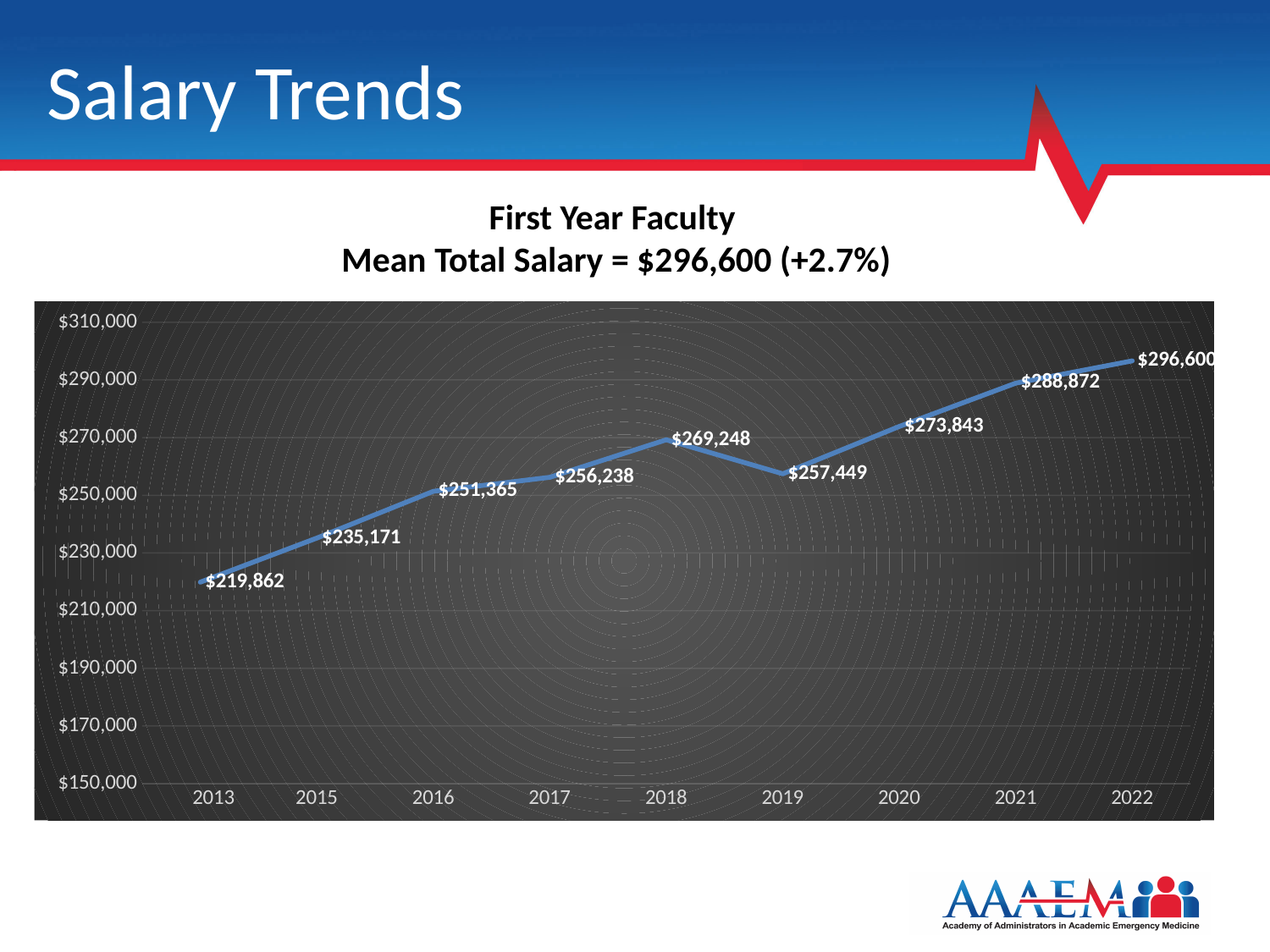
What is the difference between the mean total salary in 2018 and in 2019? $11,799 Which year has the lowest mean total salary? 2013 What is the difference between the mean total salary in 2022 and in 2021? $7,728 What kind of chart is shown on the slide? line chart What is the mean total salary for first year faculty in 2013? $219,862 Which is larger, the mean total salary in 2018 or in 2019? 2018 Is the mean total salary in 2020 greater or less than $270,000? greater Which year has the highest mean total salary? 2022 What is the percentage change shown in the chart title for the mean total salary? +2.7% What is the mean total salary for first year faculty in 2022? $296,600 How many years are plotted on the chart? 9 What is the mean total salary for first year faculty in 2019? $257,449